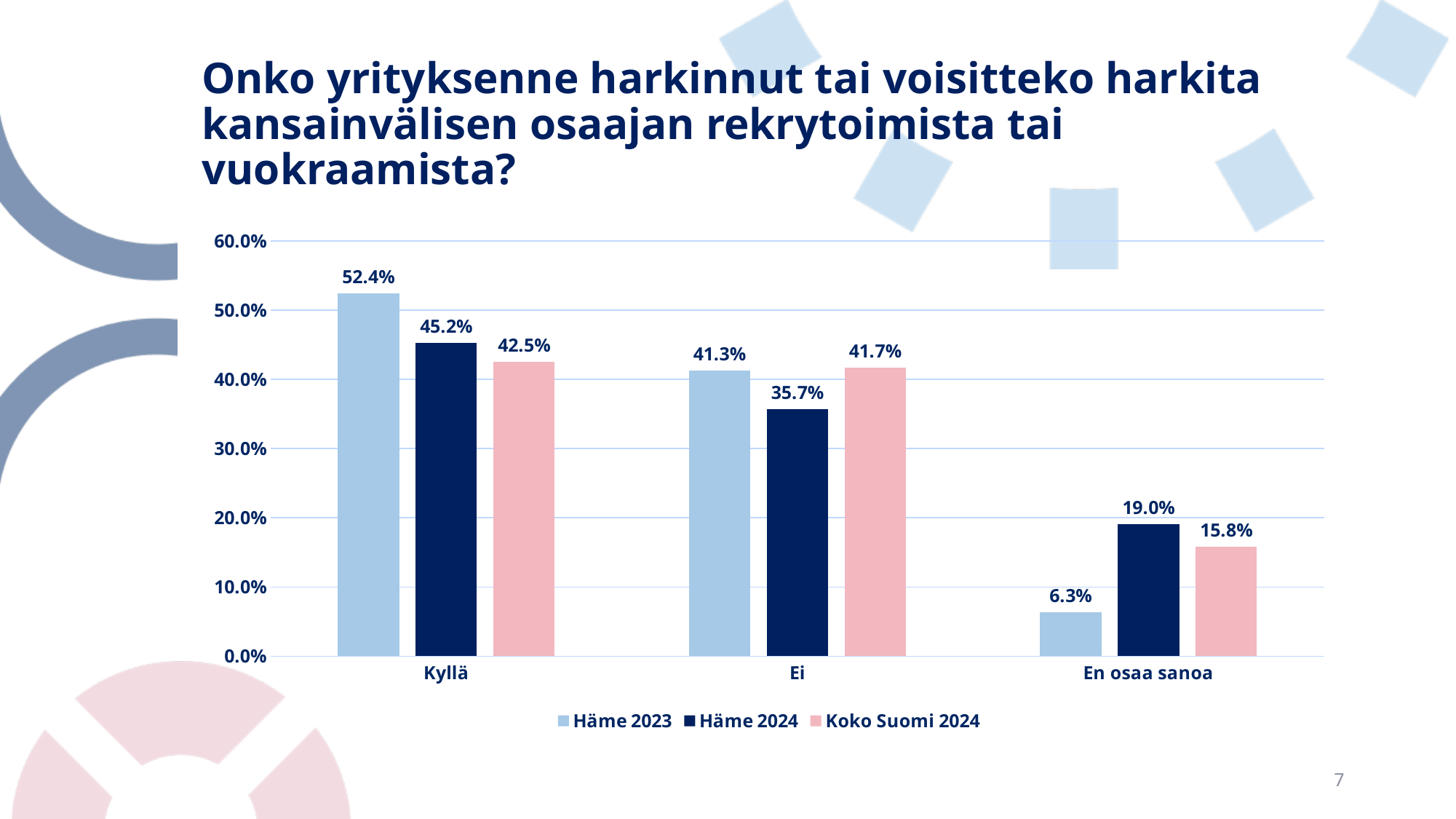
How many series does the legend list? 3 What kind of chart is shown on the slide? Bar chart What is the difference between the Häme 2023 and Häme 2024 values in the Kyllä category? 7.2% Which is larger in the Ei category: Häme 2023 or Koko Suomi 2024? Koko Suomi 2024 What is the value for Häme 2024 in the Ei category? 35.7% Which category has the lowest value for the Häme 2023 series? En osaa sanoa What is the value for Koko Suomi 2024 in the En osaa sanoa category? 15.8% Which category has the highest value for the Häme 2024 series? Kyllä Which series is shown in dark navy blue in the legend? Häme 2024 How many categories are shown on the x axis? 3 Is the value for Häme 2024 in the En osaa sanoa category greater or less than 20.0%? less What is the value for Häme 2023 in the Kyllä category? 52.4%